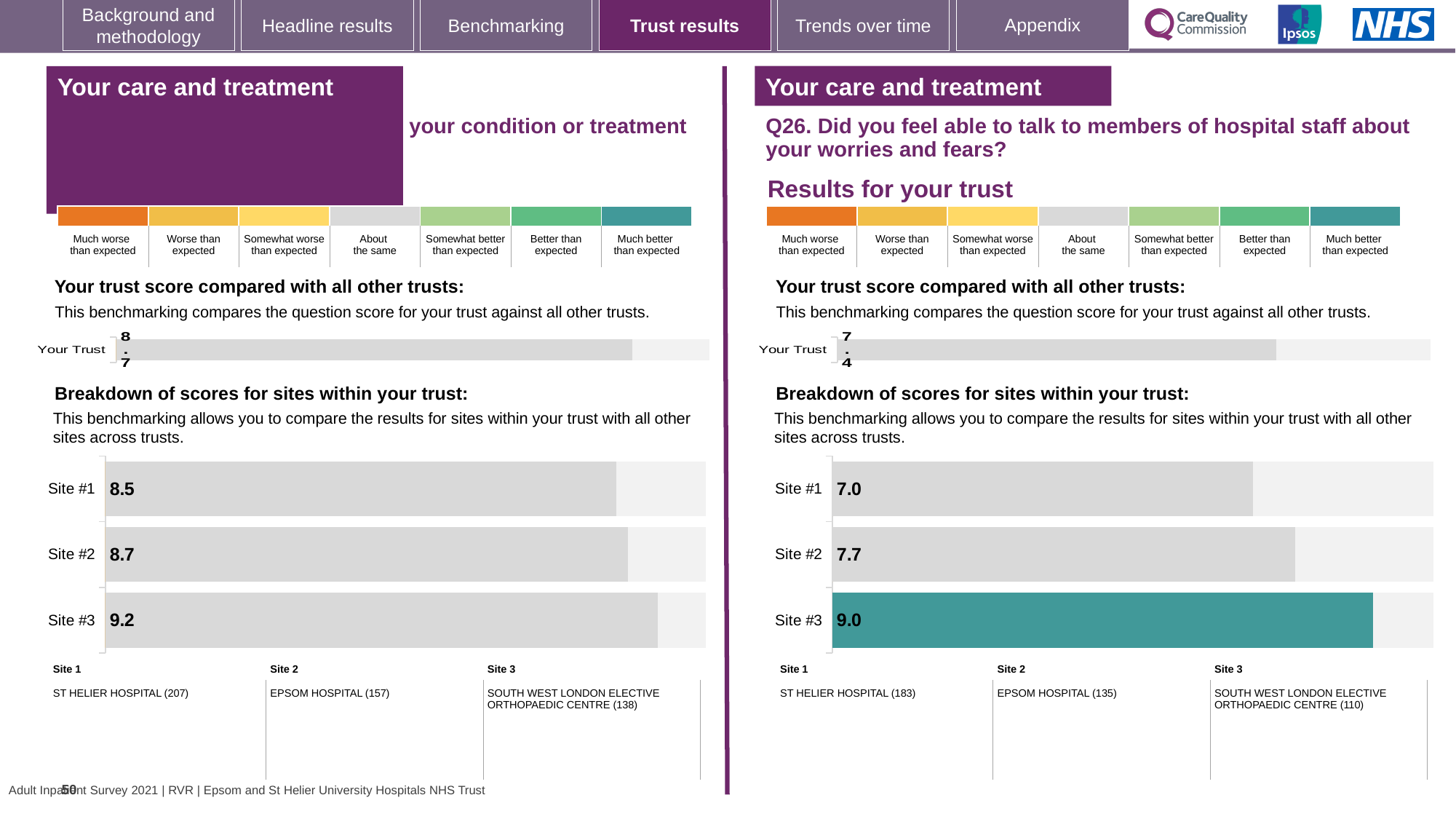
What kind of chart is the right-hand (Q26) 'Breakdown of scores for sites within your trust' chart? Bar chart On the left-hand 'Breakdown of scores for sites within your trust' chart, which site has the highest score? Site #3 On the right-hand (Q26) site breakdown chart, which has the larger score, Site #2 or Site #1? Site #2 On the right-hand (Q26) 'Breakdown of scores for sites within your trust' chart, which site has the lowest score? Site #1 On the right-hand (Q26) 'Your trust score compared with all other trusts' chart, what is the score for Your Trust? 7.4 On the right-hand (Q26) 'Breakdown of scores for sites within your trust' chart, what is the score for Site #3? 9.0 How many sites are shown on the left-hand 'Breakdown of scores for sites within your trust' chart? 3 On the right-hand (Q26) site breakdown chart, what is the difference between the scores for Site #3 and Site #1? 2.0 On the right-hand (Q26) site breakdown chart, which site's bar is coloured teal rather than grey? Site #3 On the left-hand 'Your trust score compared with all other trusts' chart, what is the score for Your Trust? 8.7 On the left-hand 'Breakdown of scores for sites within your trust' chart, what is the score for Site #1? 8.5 On the left-hand site breakdown chart, what is the difference between the scores for Site #2 and Site #1? 0.2